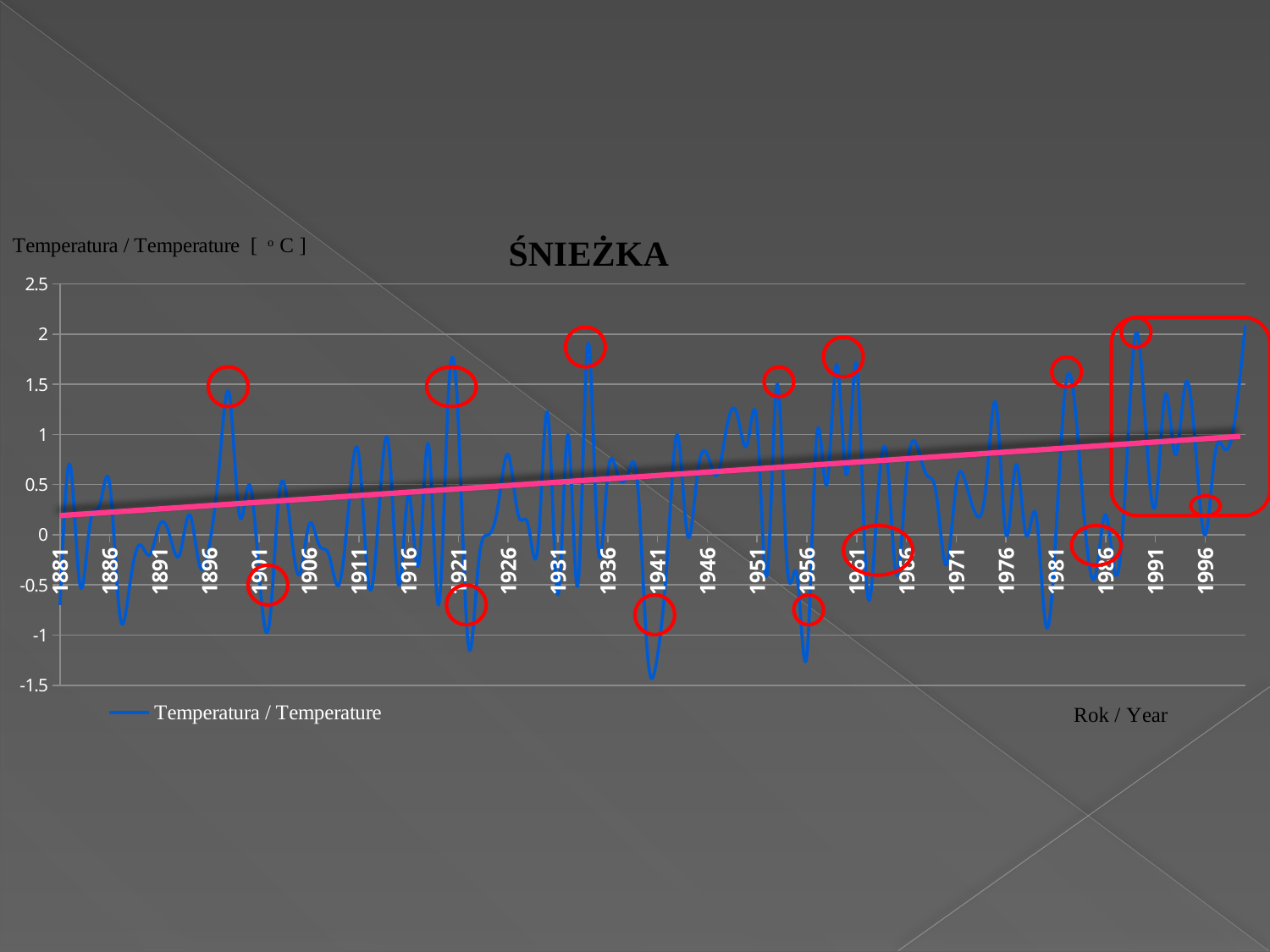
Is the temperature value at the peak near 1934 greater or less than 1.5? greater What is the label of the x axis? Rok / Year Is the pink trend line at 1881 greater or less than 0.5? less Is the temperature value at the trough near 1940 greater or less than -1? less How many series does the chart legend list? 1 What kind of chart is shown on the slide? line chart What is the highest value shown on the y axis? 2.5 What is the title of the chart? ŚNIEŻKA Does the pink trend line rise or fall from 1881 to the end of the x axis? rise